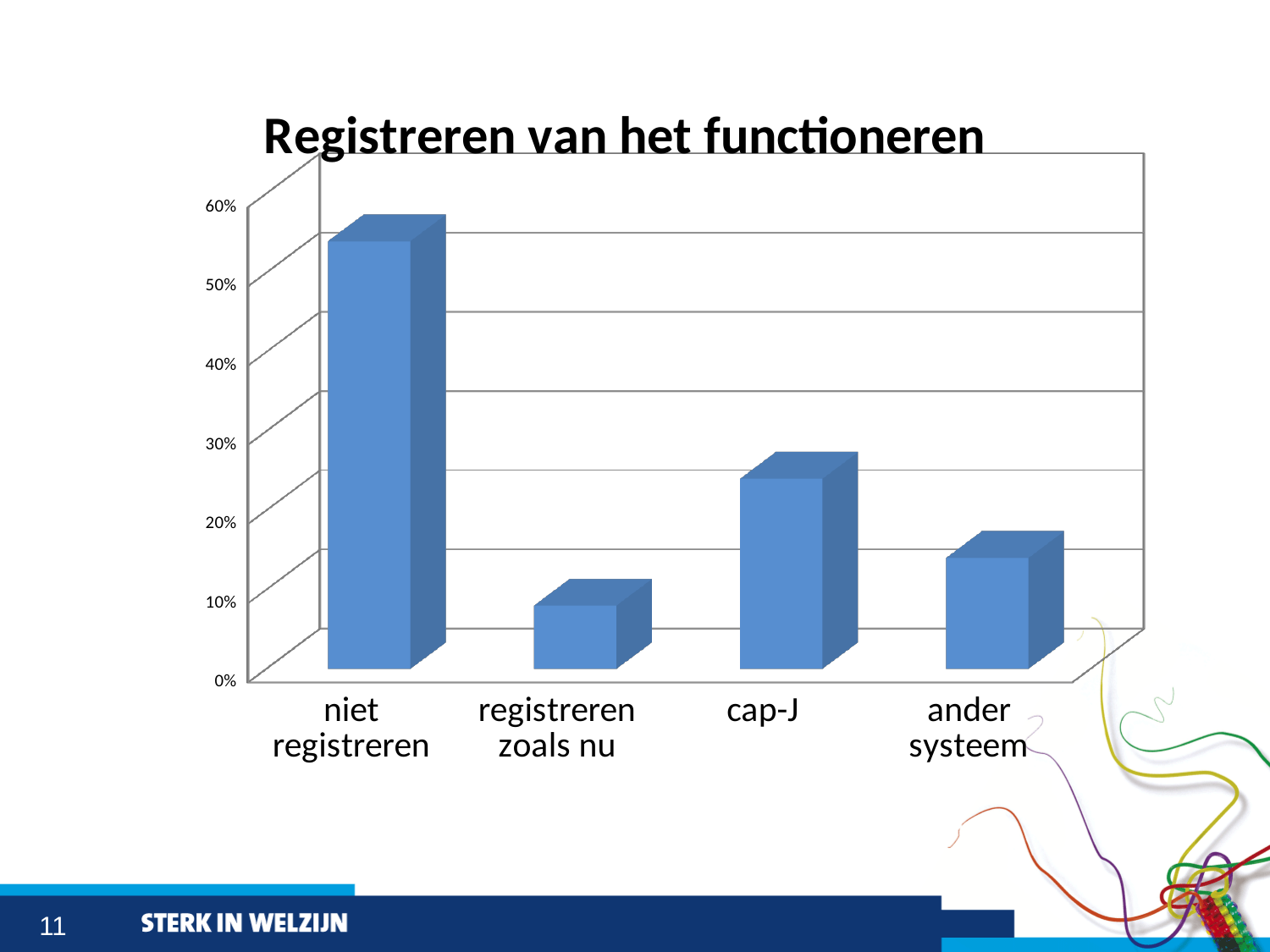
Is the value for ander systeem greater or less than 20%? less Is the value for niet registreren greater or less than 50%? greater What kind of chart is shown on the slide? bar chart Which category has the highest value in the chart? niet registreren Which has the larger value, niet registreren or cap-J? niet registreren What is the highest value shown on the vertical axis of the chart? 60% Which has the larger value, cap-J or ander systeem? cap-J Is the value for cap-J greater or less than 20%? greater Which category has the lowest value in the chart? registreren zoals nu How many categories are shown on the x axis of the chart? 4 What is the title of the chart? Registreren van het functioneren